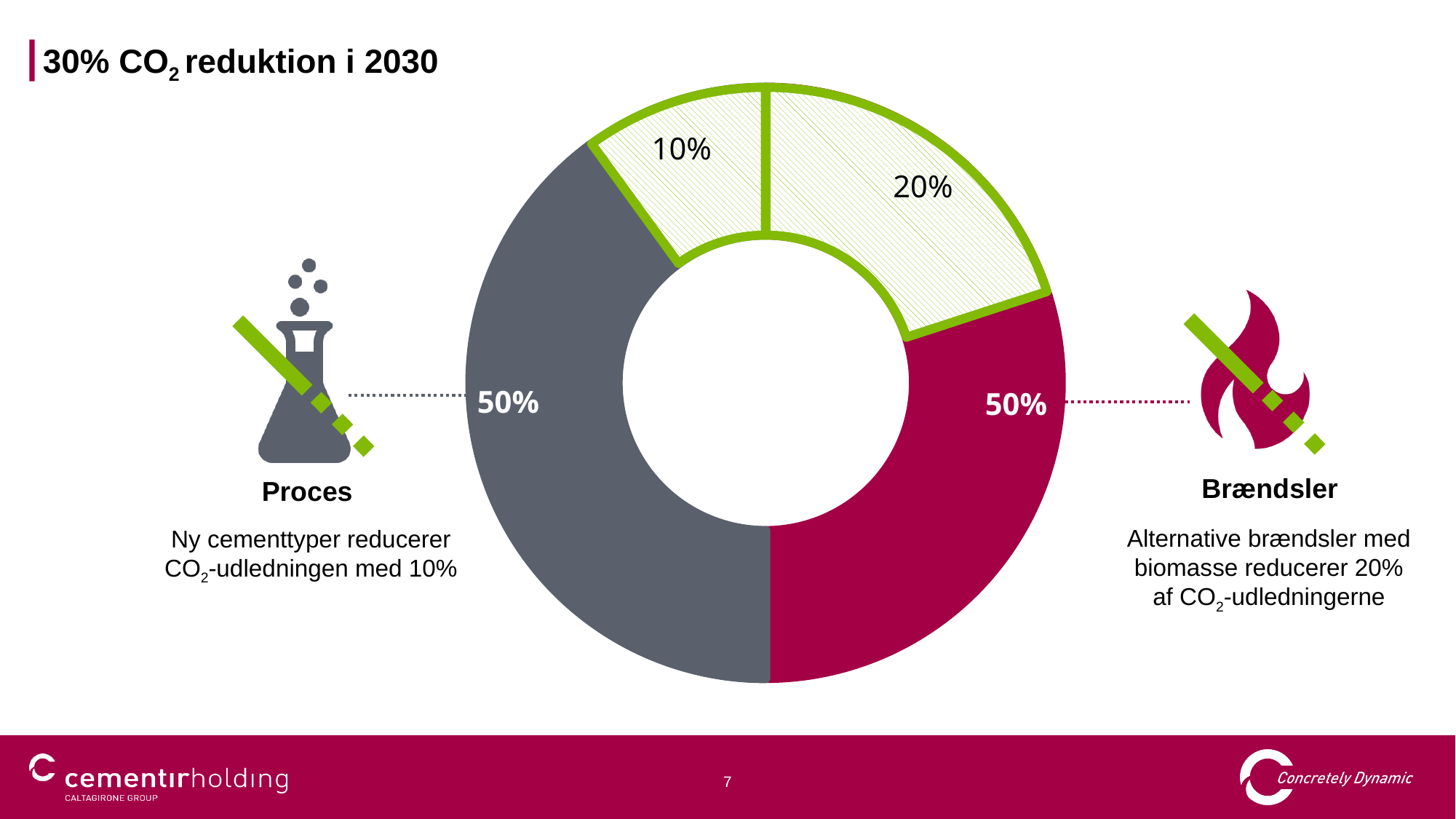
Which label is connected by a dotted line to the dark red 50% segment? Brændsler What is the difference between the two hatched segment values (20% and 10%)? 10% What value is labelled on the dark red segment of the chart? 50% How many percentage labels are printed on the chart? 4 Which label is connected by a dotted line to the grey 50% segment? Proces What is the title of the slide containing the chart? 30% CO2 reduktion i 2030 What percentage is printed in the hatched segment on the right side of the top of the chart? 20% What is the combined value of the two hatched segments (10% and 20%)? 30% Which of the two hatched segments is larger, the 10% one or the 20% one? The 20% one What kind of chart is shown on the slide? Pie chart (donut) What value is labelled on the grey segment of the chart? 50% What percentage is printed in the hatched segment on the left side of the top of the chart? 10%